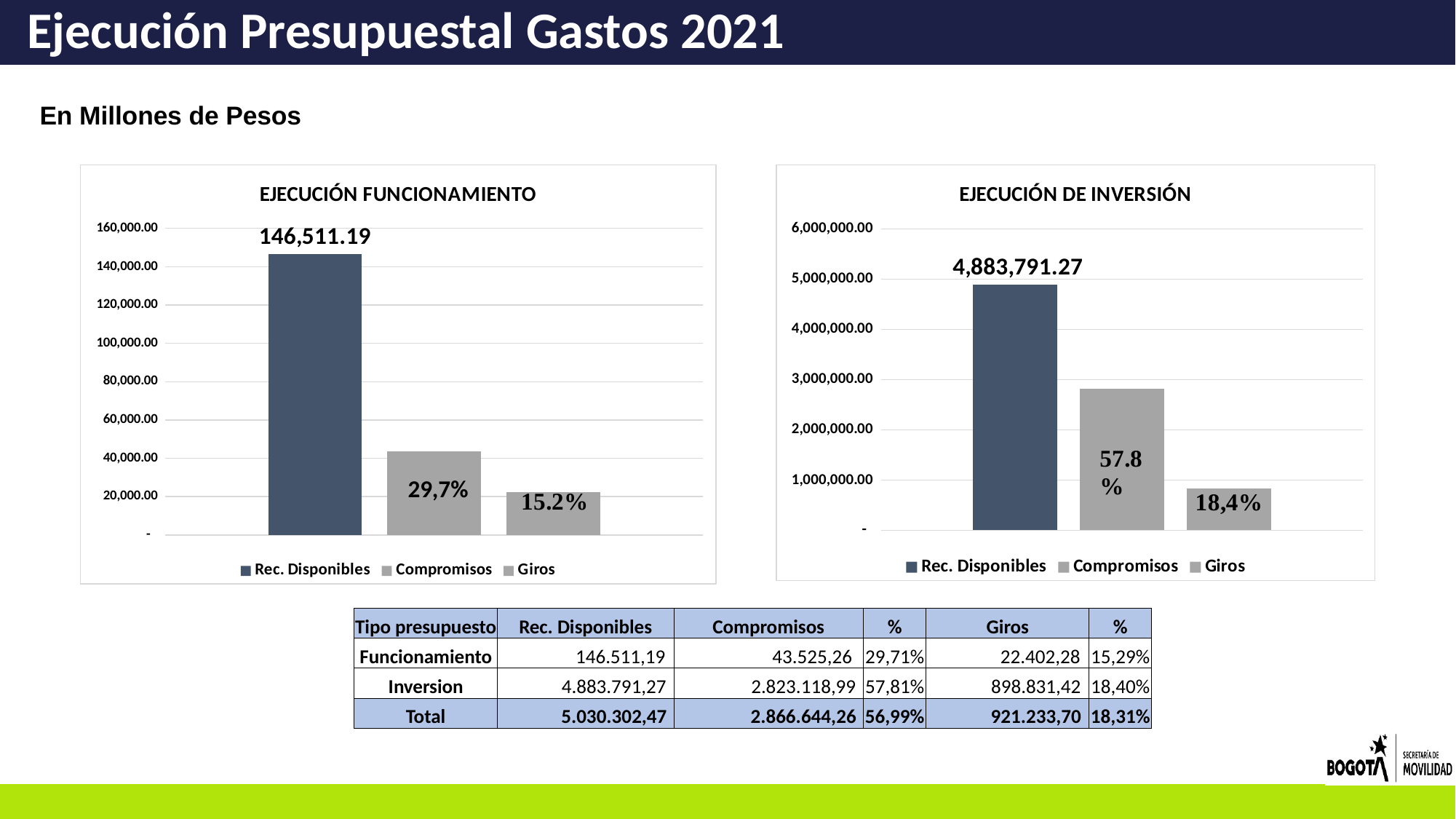
In the EJECUCIÓN FUNCIONAMIENTO chart, is the value for Giros greater or less than 40,000.00? less In the EJECUCIÓN DE INVERSIÓN chart, which is larger, Compromisos or Giros? Compromisos What kind of chart is the EJECUCIÓN DE INVERSIÓN chart? Bar chart In the EJECUCIÓN FUNCIONAMIENTO chart, which series has the tallest bar? Rec. Disponibles In the EJECUCIÓN DE INVERSIÓN chart, which series has the shortest bar? Giros In the EJECUCIÓN FUNCIONAMIENTO chart, what is the value shown for Rec. Disponibles? 146,511.19 In the EJECUCIÓN DE INVERSIÓN chart, what is the value shown for Rec. Disponibles? 4,883,791.27 In the EJECUCIÓN FUNCIONAMIENTO chart, what percentage label is printed on the Compromisos bar? 29,7% In the EJECUCIÓN DE INVERSIÓN chart, what percentage label is printed on the Giros bar? 18,4% In the EJECUCIÓN FUNCIONAMIENTO chart, what percentage label is printed on the Giros bar? 15.2% How many series does the legend of the EJECUCIÓN FUNCIONAMIENTO chart list? 3 In the EJECUCIÓN DE INVERSIÓN chart, is the value for Compromisos greater or less than 2,000,000.00? greater